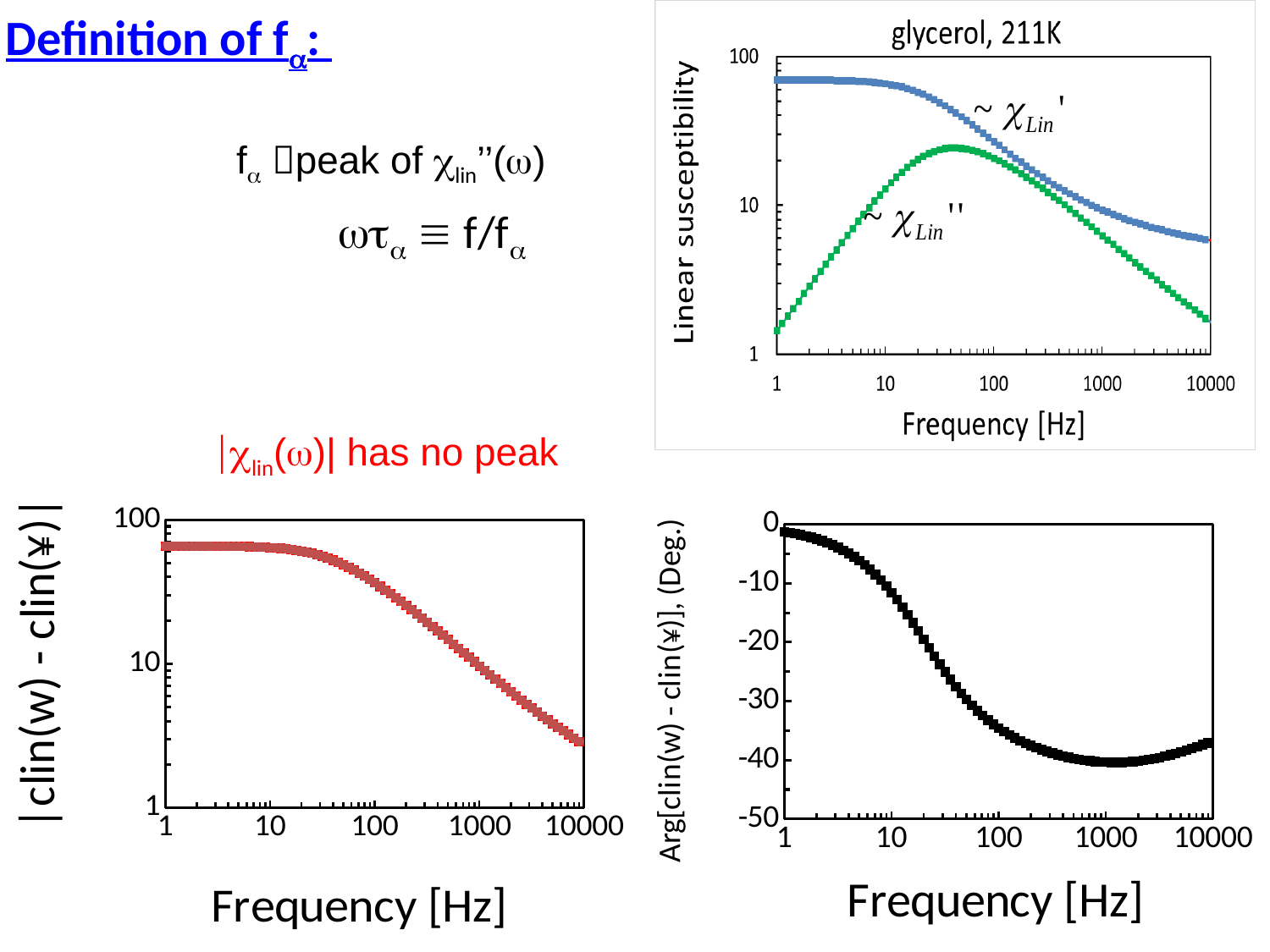
In the bottom-right chart (Arg[clin(w) - clin(¥)] vs Frequency), is the value at 100 Hz greater or less than -30? less In the top-right chart (glycerol, 211K), how many data series are plotted? 2 In the top-right chart (glycerol, 211K), does the blue χLin' curve rise or fall as frequency increases? fall In the bottom-left chart (|clin(w) - clin(¥)| vs Frequency), is the value at 10000 Hz greater or less than 10? less In the bottom-right chart (Arg[clin(w) - clin(¥)] vs Frequency), is the lowest value of the curve greater or less than -50? greater What is the title of the chart in the top-right of the slide? glycerol, 211K In the bottom-left chart (|clin(w) - clin(¥)| vs Frequency), does the curve rise or fall as frequency increases from 10 Hz to 10000 Hz? fall In the top-right chart (glycerol, 211K), what is the label of the x axis? Frequency [Hz] In the top-right chart (glycerol, 211K), at 1 Hz, which curve has the larger value, χLin' or χLin''? χLin'